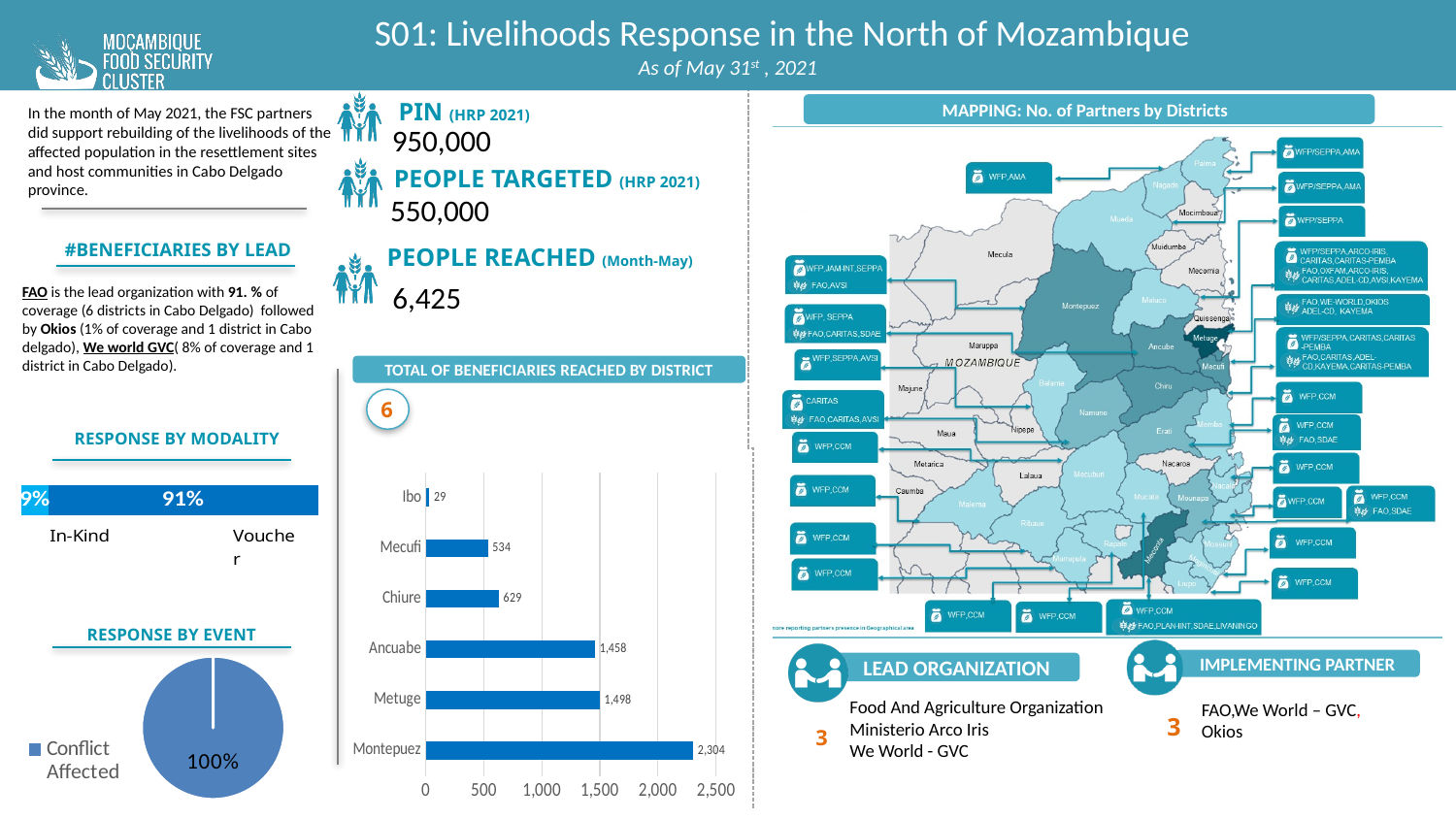
What type of chart is the 'Total of Beneficiaries Reached by District' chart? Bar chart In the 'Total of Beneficiaries Reached by District' chart, which district has more beneficiaries reached, Mecufi or Chiure? Chiure In the 'Total of Beneficiaries Reached by District' chart, how many beneficiaries were reached in Montepuez? 2,304 In the 'Total of Beneficiaries Reached by District' chart, what is the difference between the beneficiaries reached in Metuge and Ancuabe? 40 In the 'Total of Beneficiaries Reached by District' chart, which district has the highest number of beneficiaries reached? Montepuez In the 'Response by Modality' chart, what percentage of the response was delivered In-Kind? 9% In the 'Response by Event' pie chart, what share is attributed to Conflict Affected? 100% In the 'Total of Beneficiaries Reached by District' chart, how many beneficiaries were reached in Chiure? 629 In the 'Total of Beneficiaries Reached by District' chart, is the value for Ancuabe greater or less than 1,000? greater In the 'Response by Modality' chart, what percentage of the response was delivered as Voucher? 91% In the 'Total of Beneficiaries Reached by District' chart, which district has the lowest number of beneficiaries reached? Ibo In the 'Total of Beneficiaries Reached by District' chart, how many districts are shown? 6